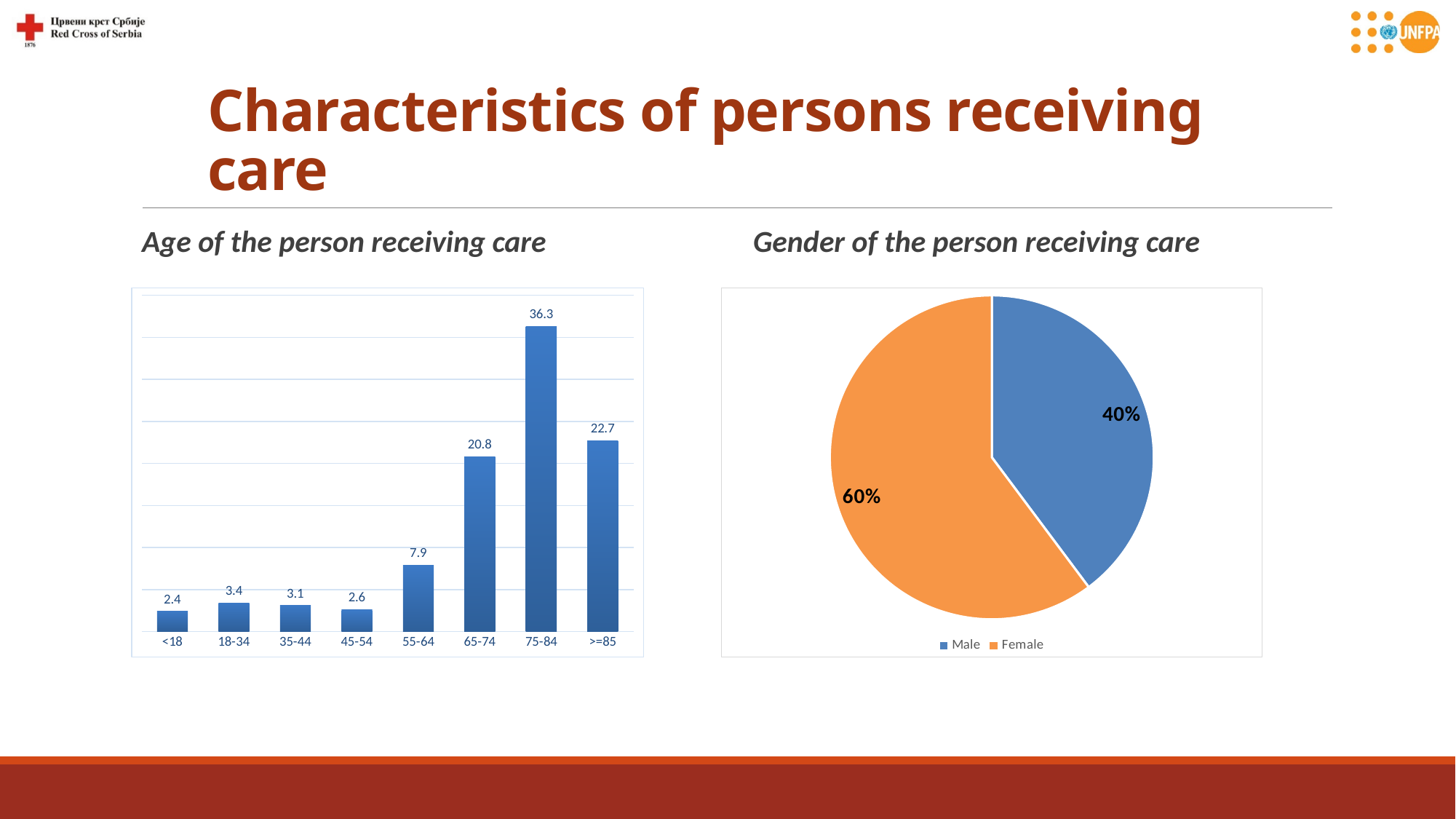
What kind of chart is the 'Age of the person receiving care' chart? Bar chart In the 'Gender of the person receiving care' chart, what is the value for Male? 40% In the 'Age of the person receiving care' chart, what is the difference between the values for 75-84 and 65-74? 15.5 In the 'Age of the person receiving care' chart, what is the value for the 55-64 age group? 7.9 In the 'Age of the person receiving care' chart, what is the value for the 75-84 age group? 36.3 How many age groups are shown in the 'Age of the person receiving care' chart? 8 How many entries does the legend of the 'Gender of the person receiving care' chart list? 2 In the 'Age of the person receiving care' chart, which age group has the highest value? 75-84 What kind of chart is the 'Gender of the person receiving care' chart? Pie chart In the 'Age of the person receiving care' chart, which age group has the lowest value? <18 In the 'Gender of the person receiving care' chart, what share of the pie is Female? 60% In the 'Age of the person receiving care' chart, which is larger, the value for 18-34 or the value for 45-54? 18-34